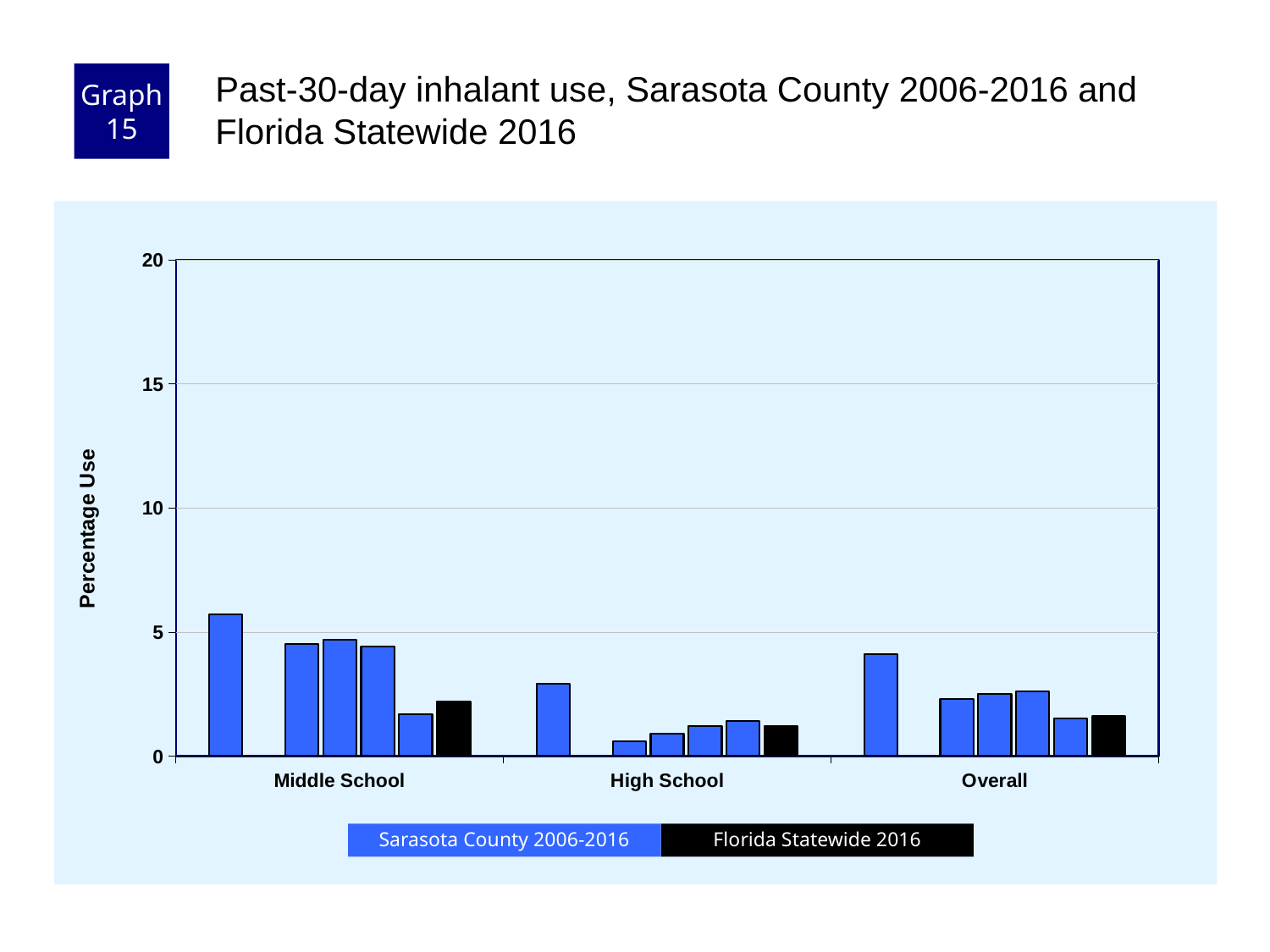
Which category group contains the shortest bar on the chart? High School Which is larger, the Florida Statewide 2016 value for Middle School or for Overall? Middle School How many series does the legend list? 2 Is the tallest Sarasota County bar in the Middle School group greater or less than 5? greater Which category group contains the tallest bar on the chart? Middle School How many categories are shown along the x axis? 3 Is the Florida Statewide 2016 value for High School greater or less than 5? less What is the label on the y axis? Percentage Use What kind of chart is shown on the slide? bar chart Which is larger, the Florida Statewide 2016 value for Middle School or for High School? Middle School Is the Florida Statewide 2016 value for Middle School greater or less than 5? less Which series is shown in black in the legend? Florida Statewide 2016